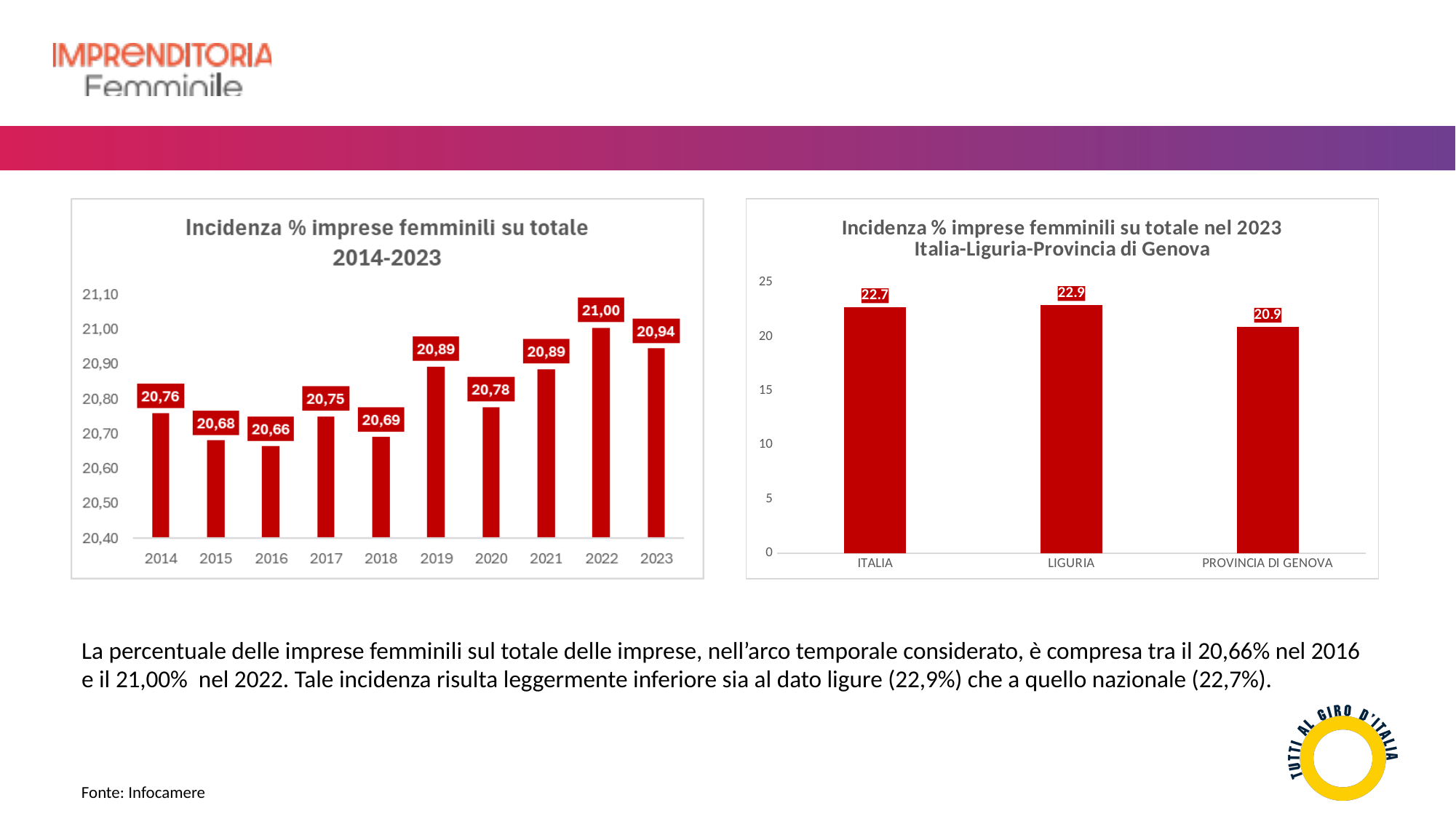
In the chart 'Incidenza % imprese femminili su totale nel 2023 Italia-Liguria-Provincia di Genova', what is the difference between the values for ITALIA and PROVINCIA DI GENOVA? 1.8 In the chart 'Incidenza % imprese femminili su totale 2014-2023', how many years are shown on the x axis? 10 In the chart 'Incidenza % imprese femminili su totale nel 2023 Italia-Liguria-Provincia di Genova', what is the value for LIGURIA? 22.9 In the chart 'Incidenza % imprese femminili su totale nel 2023 Italia-Liguria-Provincia di Genova', which category has the lowest value? PROVINCIA DI GENOVA What kind of chart is the chart on the right of the slide? Bar chart In the chart 'Incidenza % imprese femminili su totale 2014-2023', which is larger, the value for 2014 or the value for 2015? 2014 In the chart 'Incidenza % imprese femminili su totale 2014-2023', what is the value for 2016? 20,66 In the chart 'Incidenza % imprese femminili su totale nel 2023 Italia-Liguria-Provincia di Genova', how many categories are shown? 3 In the chart 'Incidenza % imprese femminili su totale 2014-2023', is the value for 2023 greater or less than 20,90? greater In the chart 'Incidenza % imprese femminili su totale 2014-2023', which year has the lowest value? 2016 In the chart 'Incidenza % imprese femminili su totale 2014-2023', what is the difference between the values for 2022 and 2016? 0,34 In the chart 'Incidenza % imprese femminili su totale 2014-2023', which year has the highest value? 2022